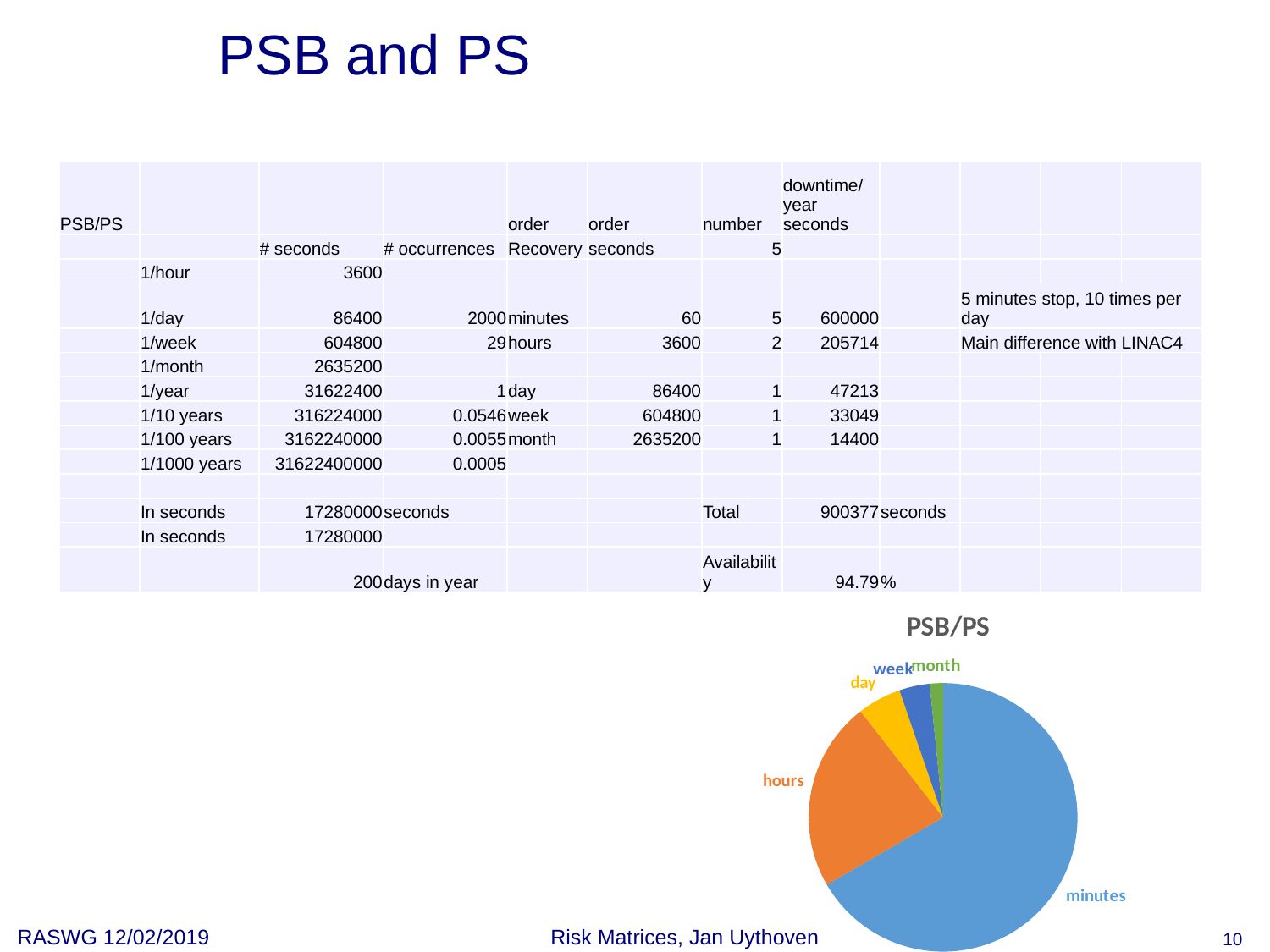
What is the title of the pie chart? PSB/PS In the pie chart, which slice is larger, hours or day? hours Which slice of the pie chart is the second largest? hours What kind of chart is shown on the slide? pie chart Which slice of the pie chart is the largest? minutes In the pie chart, which slice is larger, minutes or hours? minutes Which slice of the pie chart is the smallest? month What colour is the hours slice in the pie chart? orange In the pie chart, which slice is larger, day or week? day How many slices does the pie chart have? 5